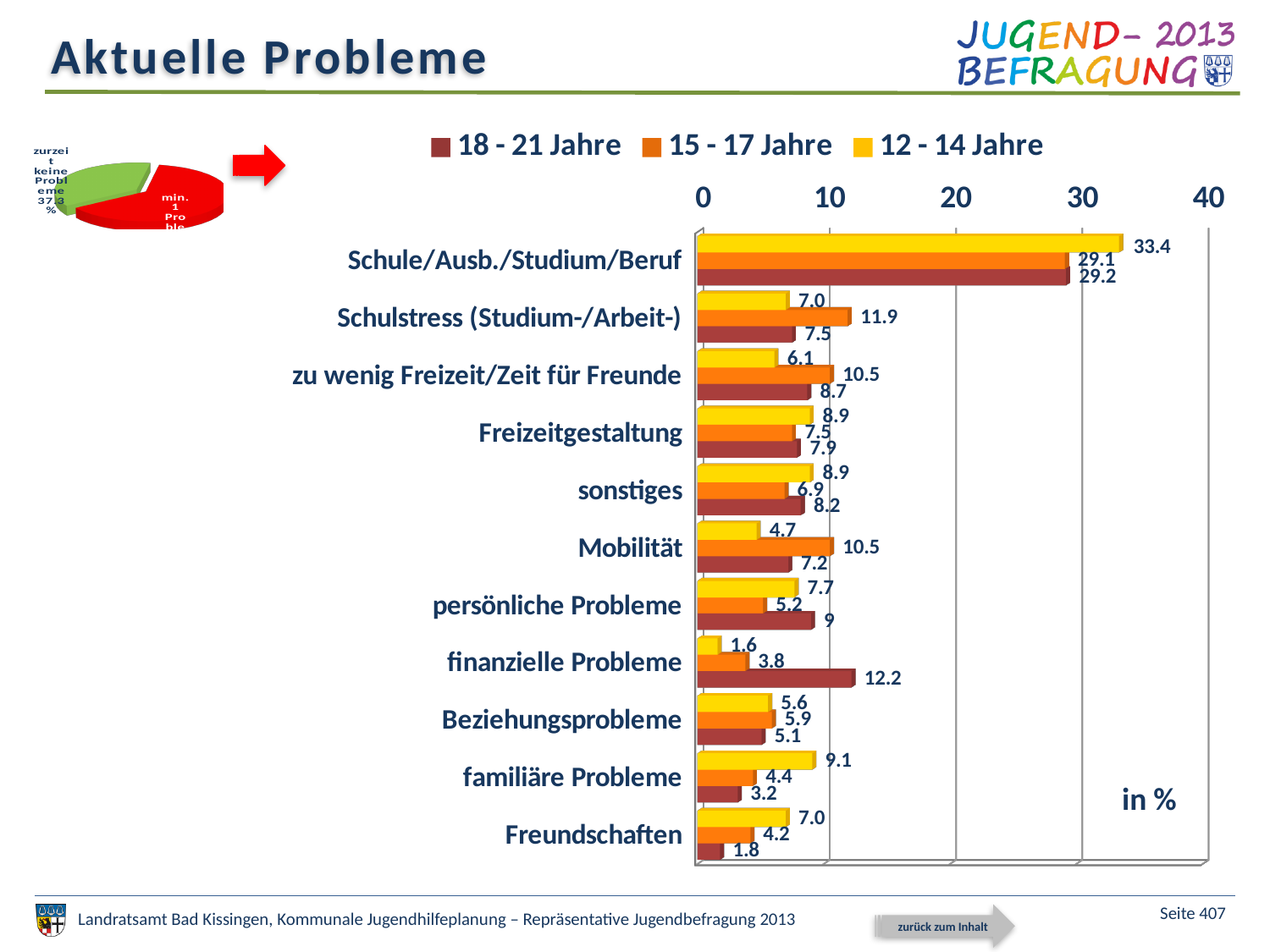
In the bar chart, what is the value for 'Mobilität' for the 15 - 17 Jahre series? 10.5 In the bar chart, which category has the lowest value for the 12 - 14 Jahre series? finanzielle Probleme In the bar chart, is the 18 - 21 Jahre value for 'Schule/Ausb./Studium/Beruf' greater or less than 20? greater In the bar chart, what unit is indicated for the values? in % In the bar chart, what is the value for 'Schule/Ausb./Studium/Beruf' for the 12 - 14 Jahre series? 33.4 In the bar chart, what is the difference between the 15 - 17 Jahre and 12 - 14 Jahre values for 'Schulstress (Studium-/Arbeit-)'? 4.9 What type of chart is the large chart on the right of the slide? bar chart In the bar chart, what is the value for 'finanzielle Probleme' for the 18 - 21 Jahre series? 12.2 How many categories are shown in the bar chart? 11 In the bar chart, which category has the highest value for the 18 - 21 Jahre series? Schule/Ausb./Studium/Beruf How many series does the legend of the bar chart list? 3 In the bar chart, for 'familiäre Probleme', which series has the larger value: 12 - 14 Jahre or 18 - 21 Jahre? 12 - 14 Jahre